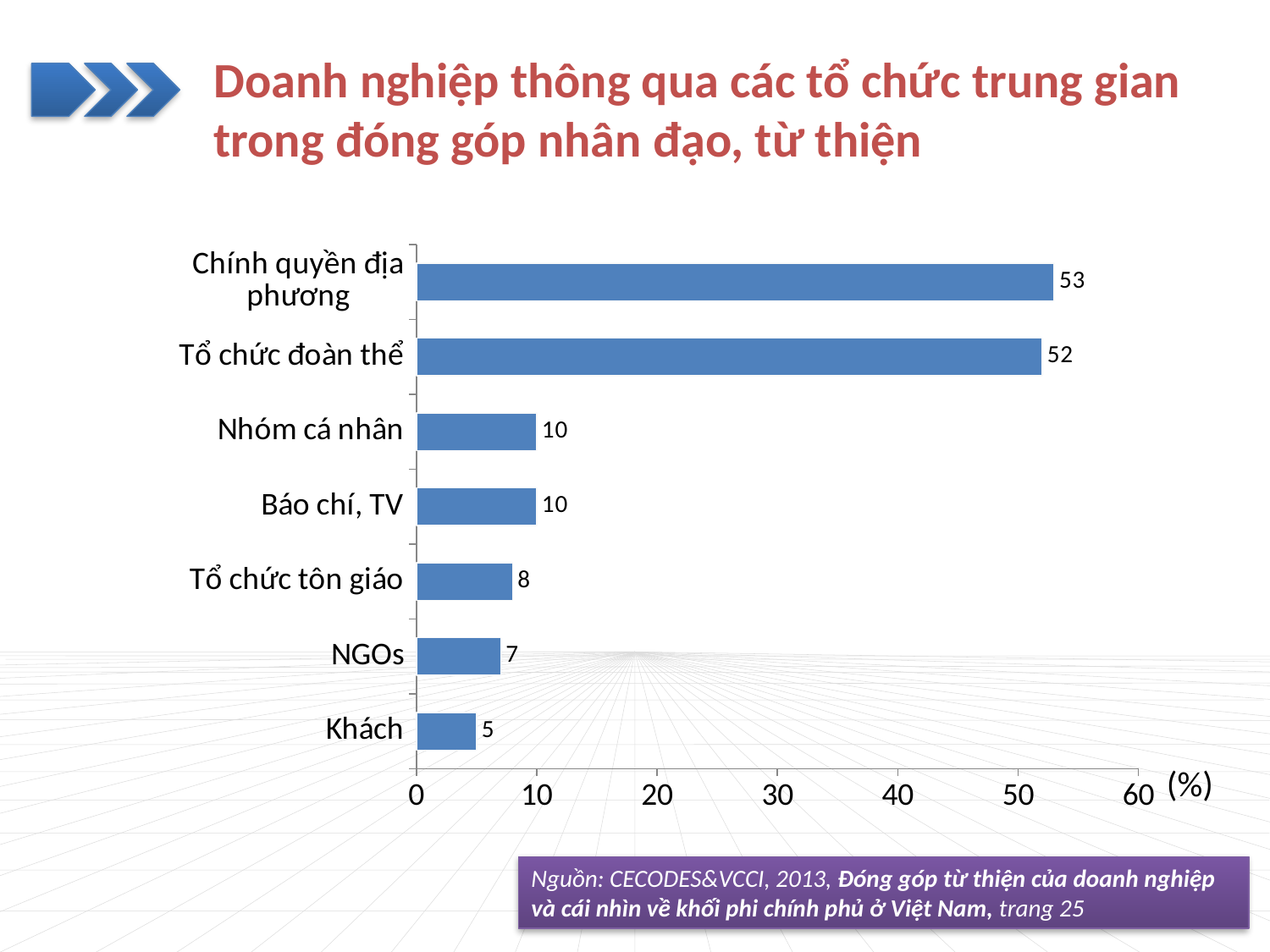
What kind of chart is shown on the slide? Bar chart What is the value for Chính quyền địa phương? 53 What unit is shown at the end of the horizontal axis? (%) How many categories are shown in the chart? 7 Which category has the lowest value? Khách What is the difference between the values for Chính quyền địa phương and Tổ chức đoàn thể? 1 What is the value for Tổ chức đoàn thể? 52 What is the value for NGOs? 7 What is the value for Khách? 5 What is the difference between the values for Nhóm cá nhân and Khách? 5 Which category has the highest value? Chính quyền địa phương Which is larger, the value for Tổ chức tôn giáo or the value for NGOs? Tổ chức tôn giáo